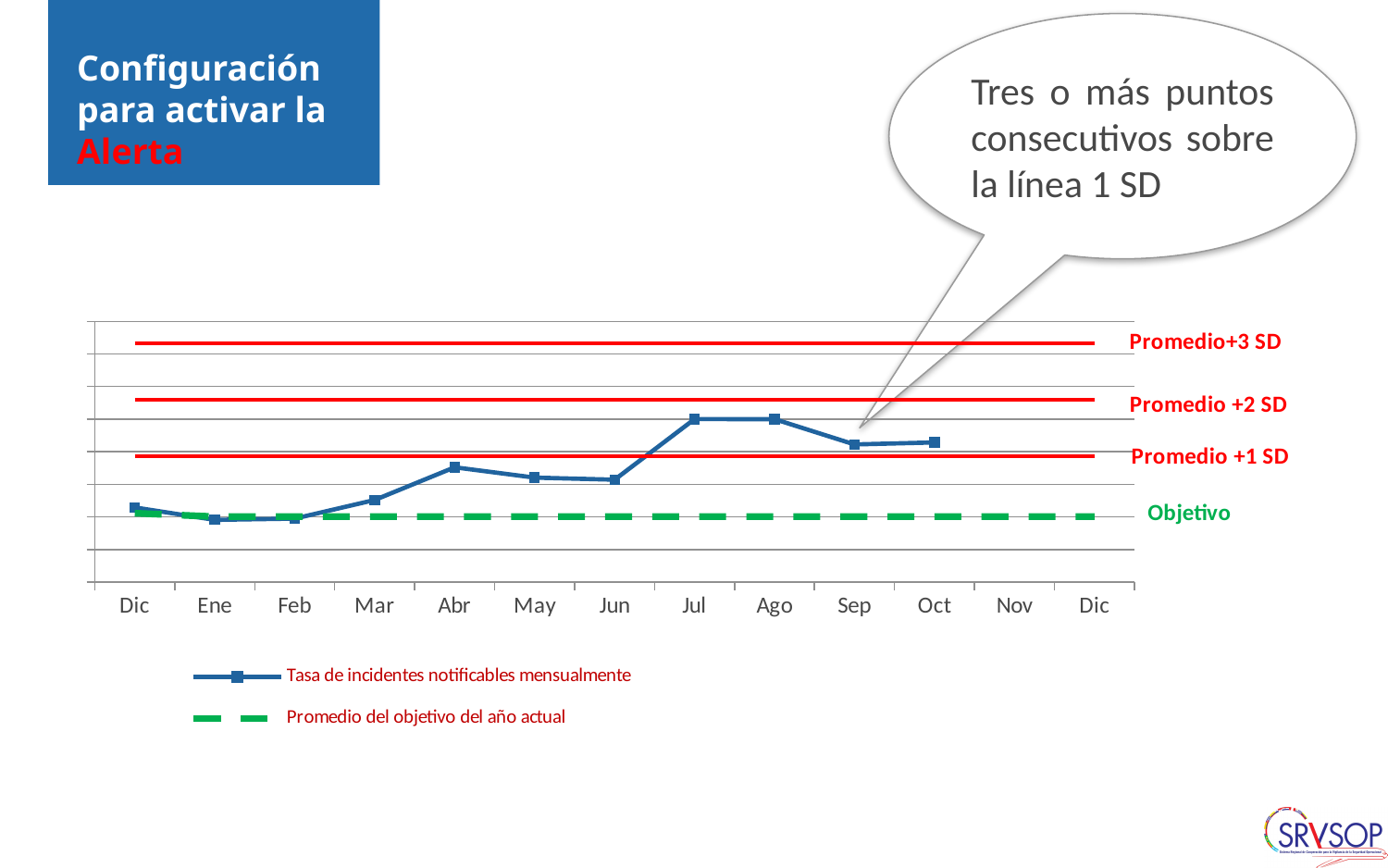
What kind of chart is shown on the slide? line chart Which is higher for 'Tasa de incidentes notificables mensualmente': Oct or Jun? Oct What is the label of the green dashed line in the chart legend? Promedio del objetivo del año actual What is the label of the topmost red horizontal line on the chart? Promedio+3 SD How many series does the chart legend list? 2 How many month labels are shown along the x axis of the chart? 13 Does the 'Tasa de incidentes notificables mensualmente' line rise or fall from Feb to Jul? rise How many data points are plotted for the 'Tasa de incidentes notificables mensualmente' series? 11 Which is higher for 'Tasa de incidentes notificables mensualmente': Jul or Sep? Jul Which is higher for 'Tasa de incidentes notificables mensualmente': Abr or Mar? Abr Does the 'Tasa de incidentes notificables mensualmente' line rise or fall from Ago to Sep? fall